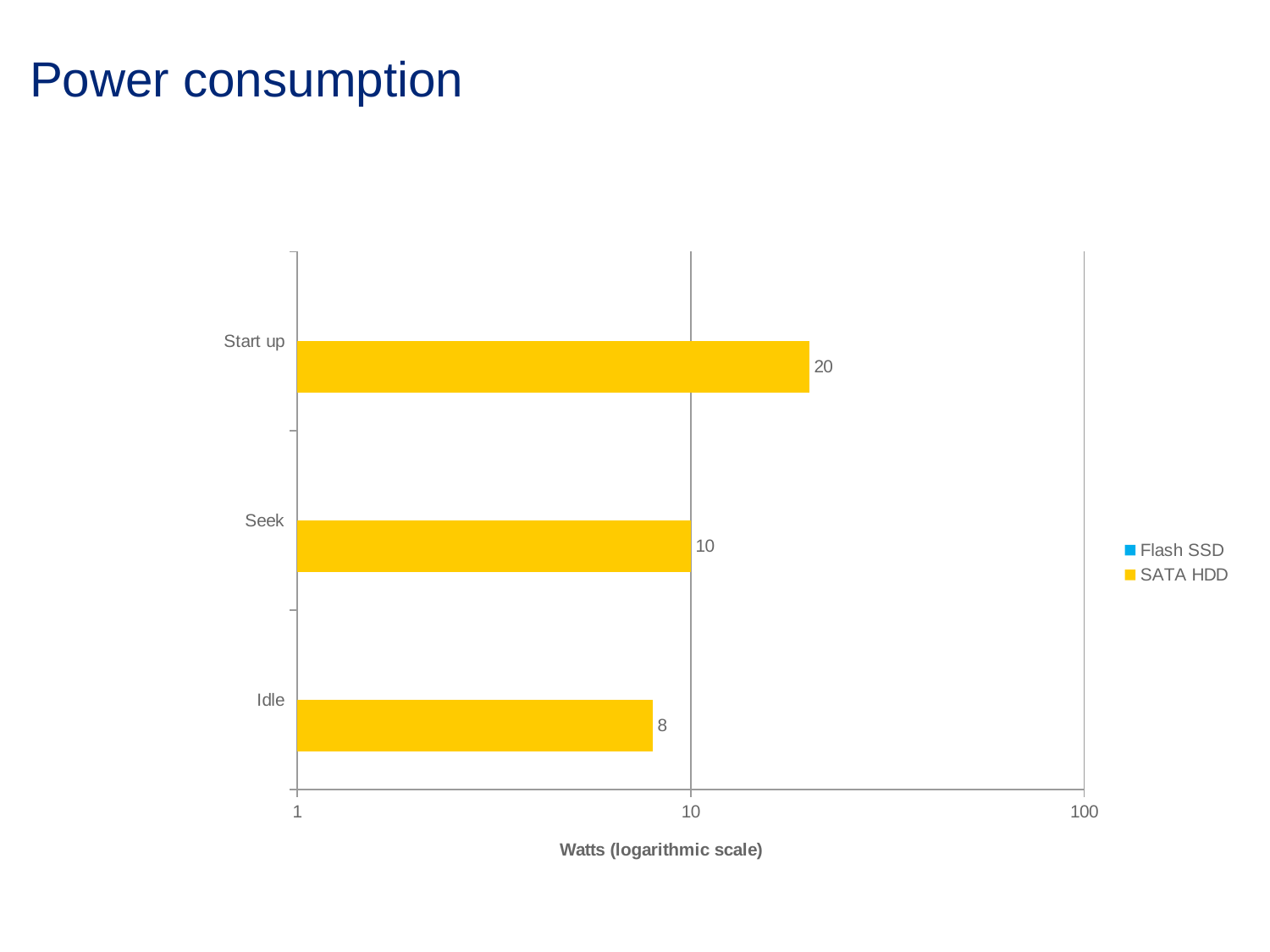
How many categories are shown on the chart? 3 What is the SATA HDD power consumption for Seek? 10 Is the SATA HDD value for Idle greater or less than 10? less How many series does the legend list? 2 What is the SATA HDD power consumption for Start up? 20 Which is larger, the SATA HDD value for Start up or for Seek? Start up Which category has the highest SATA HDD power consumption? Start up What is the difference between the SATA HDD values for Start up and Idle? 12 What is the difference between the SATA HDD values for Seek and Idle? 2 What is the SATA HDD power consumption for Idle? 8 What kind of chart is shown on the slide? bar chart Which category has the lowest SATA HDD power consumption? Idle